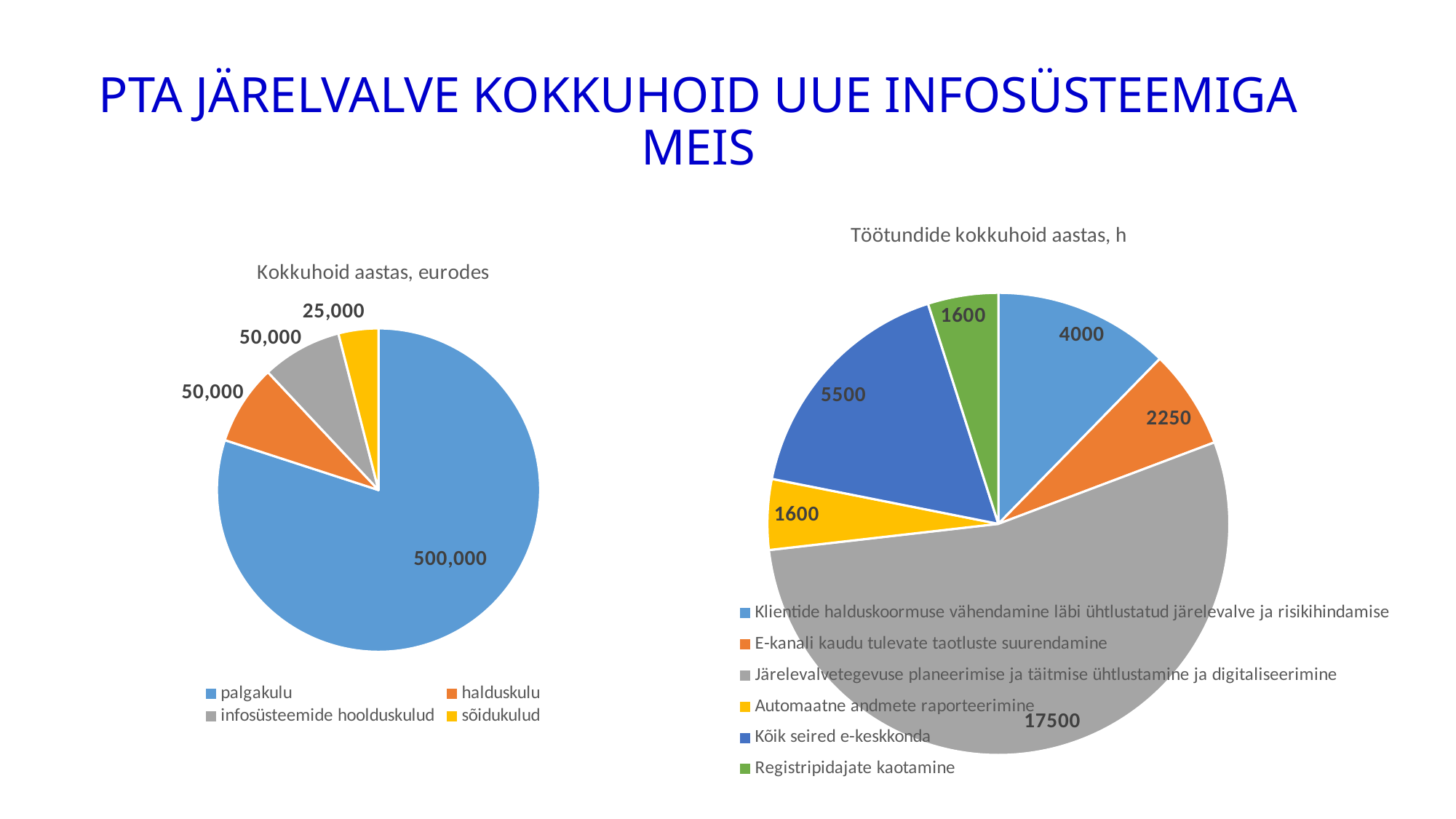
In the chart titled "Kokkuhoid aastas, eurodes", what share of the total does palgakulu represent? 80% In the chart titled "Kokkuhoid aastas, eurodes", how many categories does the legend list? 4 In the chart titled "Töötundide kokkuhoid aastas, h", what is the value for Kõik seired e-keskkonda? 5500 In the chart titled "Töötundide kokkuhoid aastas, h", how many categories does the legend list? 6 In the chart titled "Kokkuhoid aastas, eurodes", what is the value for sõidukulud? 25,000 In the chart titled "Kokkuhoid aastas, eurodes", what is the value for palgakulu? 500,000 What type of chart is the chart on the right of the slide? Pie chart In the chart titled "Töötundide kokkuhoid aastas, h", which is larger: Kõik seired e-keskkonda or Klientide halduskoormuse vähendamine läbi ühtlustatud järelevalve ja risikihindamise? Kõik seired e-keskkonda In the chart titled "Töötundide kokkuhoid aastas, h", which category has the largest slice? Järelevalvetegevuse planeerimise ja täitmise ühtlustamine ja digitaliseerimine In the chart titled "Töötundide kokkuhoid aastas, h", what is the value for E-kanali kaudu tulevate taotluste suurendamine? 2250 In the chart titled "Kokkuhoid aastas, eurodes", what is the difference between palgakulu and halduskulu? 450,000 In the chart titled "Kokkuhoid aastas, eurodes", which category has the smallest slice? sõidukulud